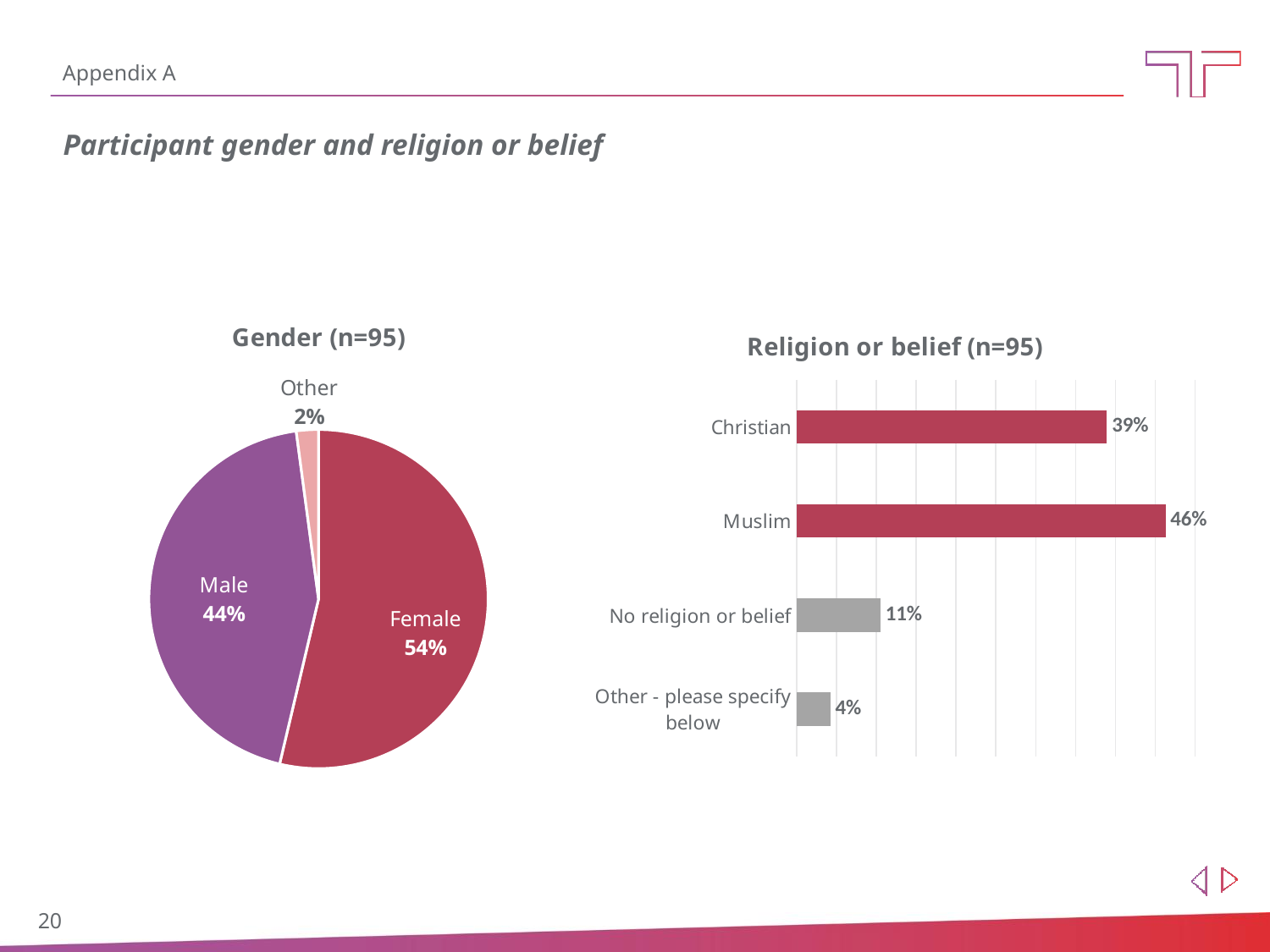
In the Gender (n=95) chart, which category has the largest slice? Female In the Religion or belief (n=95) chart, which is larger, Christian or Muslim? Muslim In the Religion or belief (n=95) chart, what is the value for No religion or belief? 11% In the Gender (n=95) chart, what share of participants are Female? 54% In the Religion or belief (n=95) chart, which category has the lowest value? Other - please specify below In the Gender (n=95) chart, what share of participants are Other? 2% How many categories does the Religion or belief (n=95) chart show? 4 In the Gender (n=95) chart, what is the difference between the Female and Male shares? 10% In the Gender (n=95) chart, what share of participants are Male? 44% In the Religion or belief (n=95) chart, what is the value for Muslim? 46% In the Religion or belief (n=95) chart, what is the difference between Christian and No religion or belief? 28% What kind of chart is the Gender (n=95) chart? Pie chart